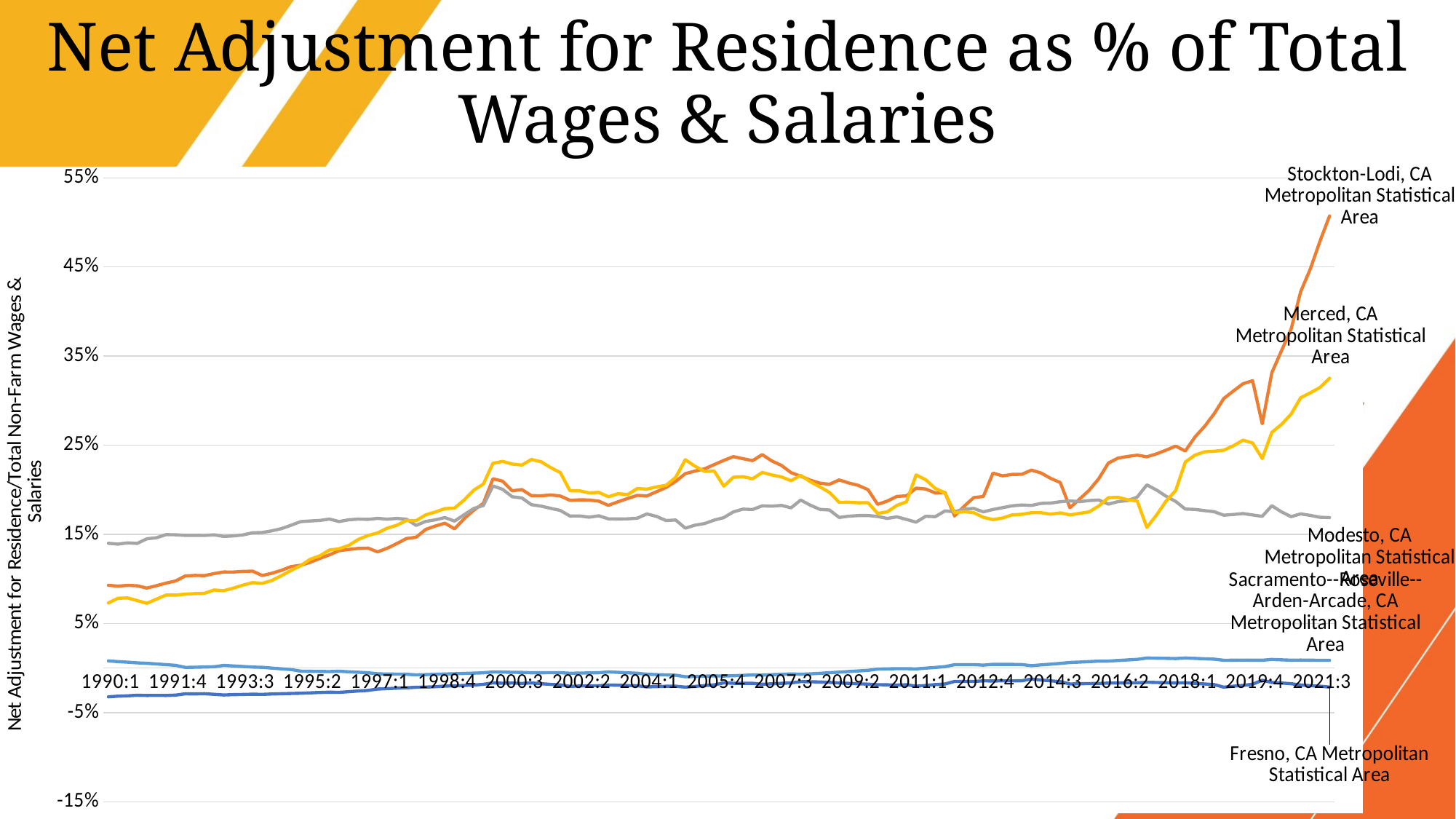
Is the value for Fresno, CA Metropolitan Statistical Area at 2021:3 greater or less than 5%? less Does the value for Stockton-Lodi, CA Metropolitan Statistical Area generally rise or fall from 1990:1 to 2021:3? rise What kind of chart is shown on the slide? line chart Is the value for Merced, CA Metropolitan Statistical Area at 2021:3 greater or less than 35%? less What is the title of the chart? Net Adjustment for Residence as % of Total Wages & Salaries Is the value for Stockton-Lodi, CA Metropolitan Statistical Area at 2021:3 greater or less than 45%? greater Which series has the highest value at the end of the chart (2021:3)? Stockton-Lodi, CA Metropolitan Statistical Area Which series has the lowest value at the end of the chart (2021:3)? Fresno, CA Metropolitan Statistical Area At 2021:3, which is larger: the value for Merced, CA Metropolitan Statistical Area or Modesto, CA Metropolitan Statistical Area? Merced, CA Metropolitan Statistical Area How many metropolitan statistical areas (series) are plotted on the chart? 5 What is the highest value shown on the y-axis? 55%